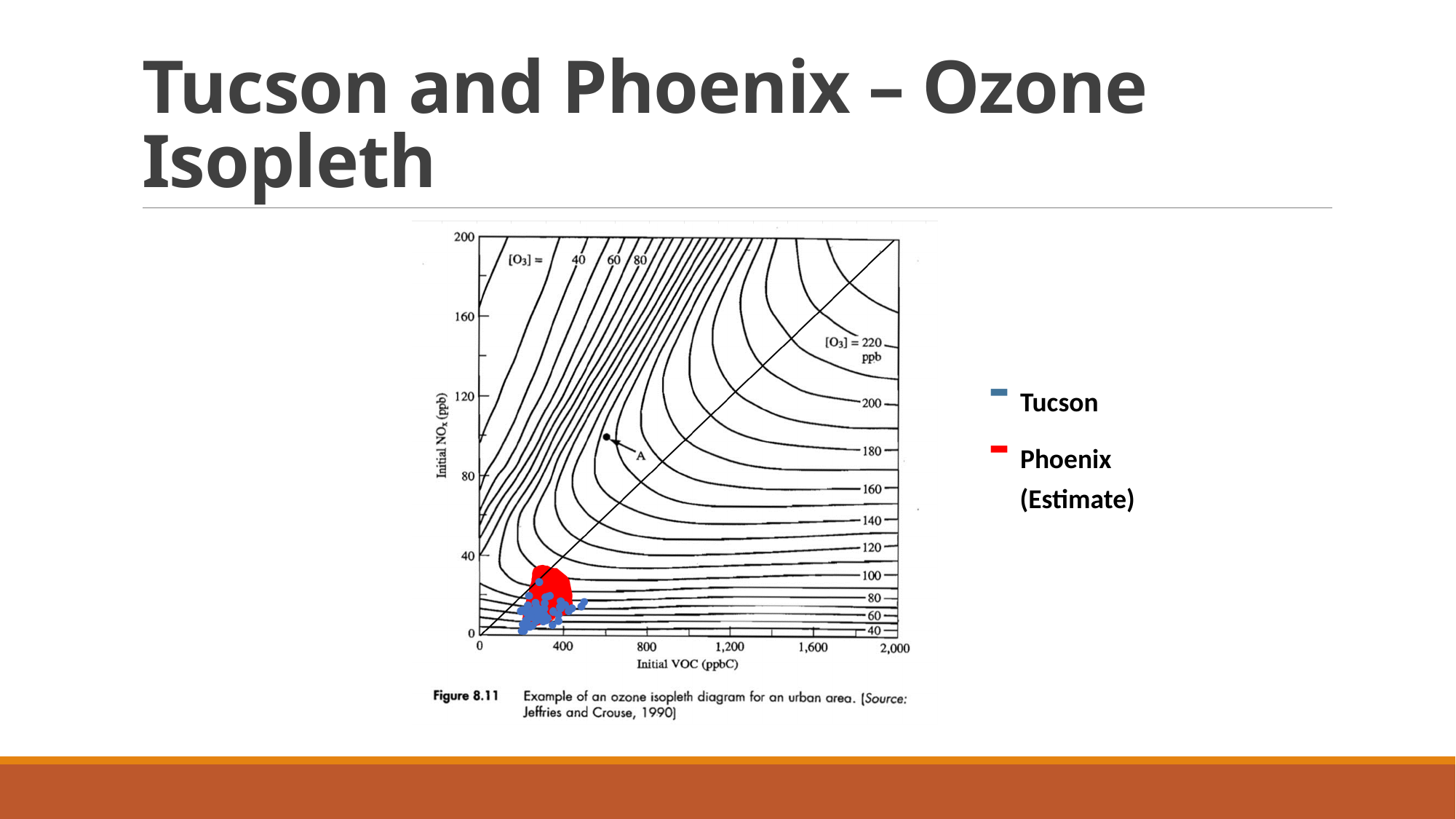
What is the highest ozone concentration labelled on an isopleth in the chart? 220 ppb What kind of chart is shown on the slide? An ozone isopleth (contour) diagram with overlaid data points What is the label of the x axis? Initial VOC (ppbC) What is the maximum value shown on the x axis? 2,000 What colour represents Phoenix (Estimate) on the chart? Red How many series does the legend list? 2 What is the label of the y axis? Initial NOx (ppb) Is the Initial NOx value of point A greater or less than 80 ppb? greater What is the lowest ozone concentration labelled on an isopleth in the chart? 40 Are the Tucson data points at Initial NOx values greater or less than 40 ppb? less Which two series are listed in the legend? Tucson and Phoenix (Estimate) Is the Initial VOC of the Phoenix (Estimate) region greater or less than 800 ppbC? less